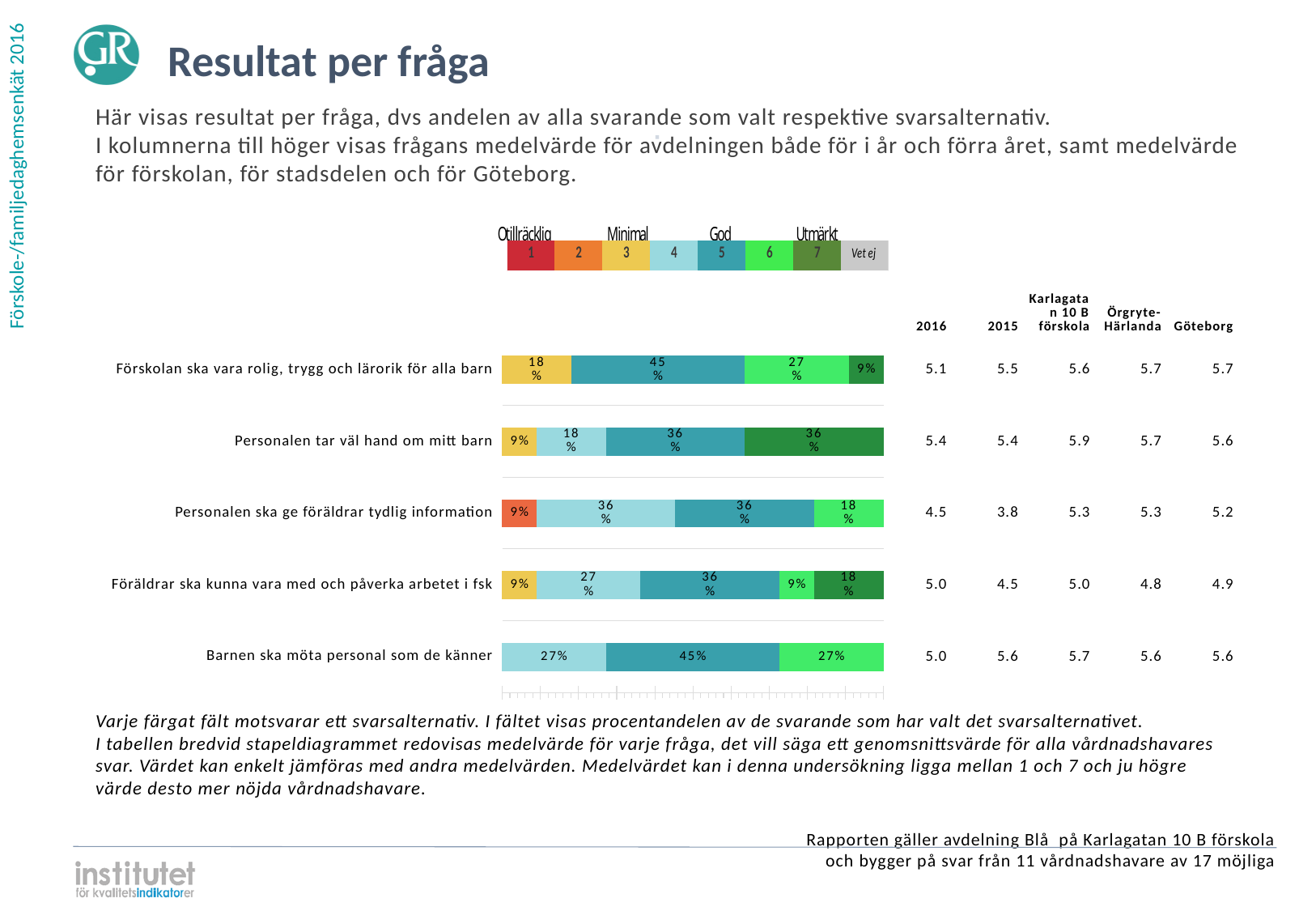
What is the 2016 mean value shown for 'Personalen ska ge föräldrar tydlig information'? 4.5 How many questions (categories) are shown as bars in the chart? 5 How many coloured segments does the bar for 'Föräldrar ska kunna vara med och påverka arbetet i fsk' have? 5 How many response alternatives does the legend above the chart list? 8 What label does the legend give to response alternative 7? Utmärkt For 'Föräldrar ska kunna vara med och påverka arbetet i fsk', which is larger: the share choosing 4 or the share choosing 5? 5 What percentage chose alternative 7 (Utmärkt) for 'Personalen tar väl hand om mitt barn'? 36% For 'Förskolan ska vara rolig, trygg och lärorik för alla barn', what is the difference between the share choosing 5 (45%) and the share choosing 7 (9%)? 36 percentage points What percentage of respondents chose alternative 5 (God) for 'Barnen ska möta personal som de känner'? 45% Which question has the largest share of respondents choosing alternative 7 (dark green)? Personalen tar väl hand om mitt barn What kind of chart is used to show the results per question? Stacked bar chart What percentage chose alternative 2 for 'Personalen ska ge föräldrar tydlig information'? 9%